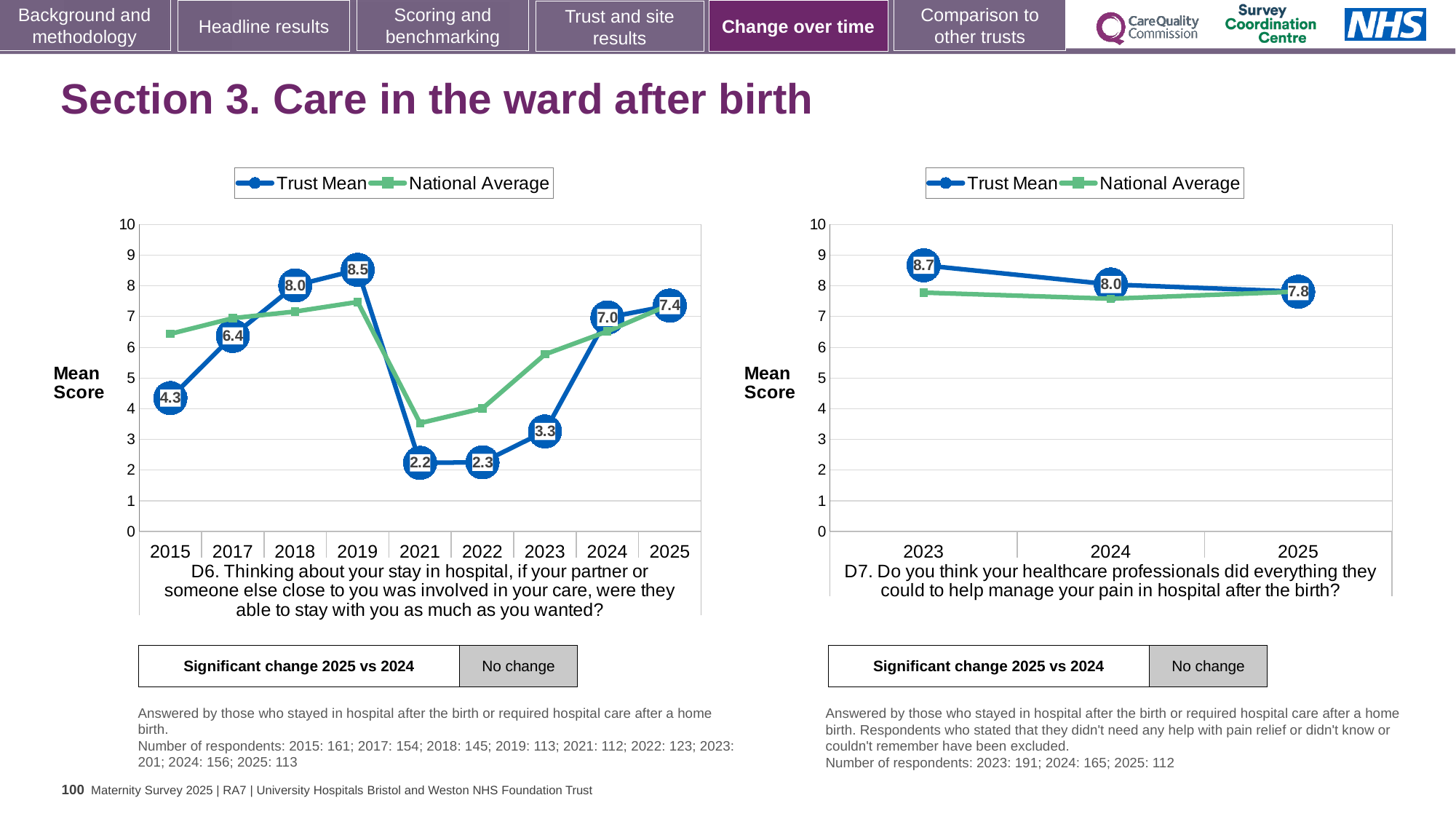
What kind of chart is the right chart (D7)? Line chart In the right chart (D7), does the Trust Mean rise or fall from 2023 to 2025? Fall In the right chart (D7), what is the difference between the Trust Mean for 2023 and 2025? 0.9 In the left chart (D6), which year has the lowest Trust Mean? 2021 In the right chart (D7), what is the Trust Mean for 2023? 8.7 In the left chart (D6), which is larger, the Trust Mean for 2015 or for 2017? 2017 In the left chart (D6), is the National Average for 2021 greater or less than 4? less How many years are plotted on the x axis of the right chart (D7)? 3 In the left chart (D6), what is the Trust Mean for 2021? 2.2 How many series does the legend of the left chart (D6) list? 2 In the left chart (D6), what is the Trust Mean for 2019? 8.5 In the left chart (D6), which year has the highest Trust Mean? 2019